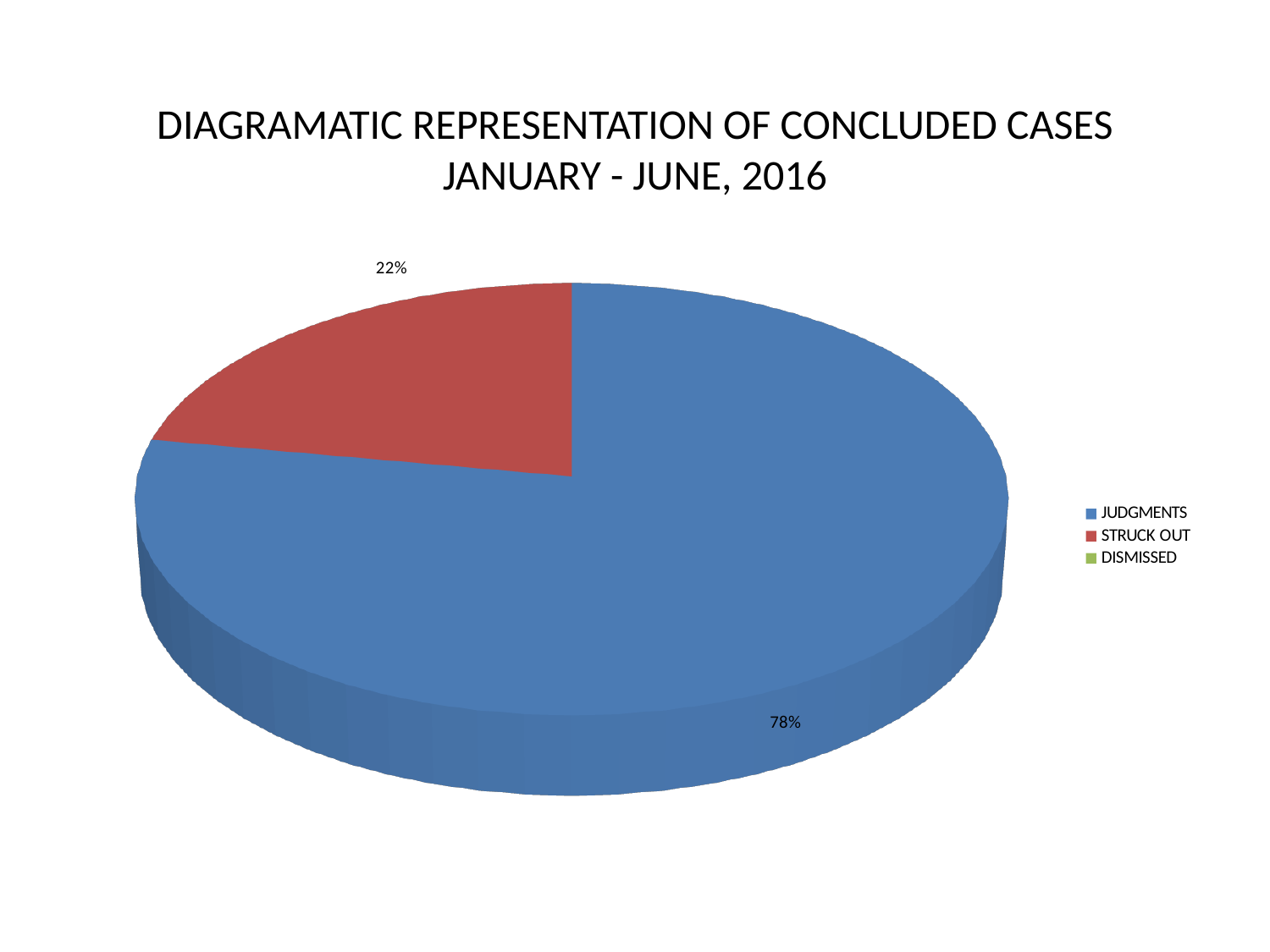
How many categories does the legend list? 3 What is the title of the chart? DIAGRAMATIC REPRESENTATION OF CONCLUDED CASES JANUARY - JUNE, 2016 Which of JUDGMENTS or STRUCK OUT has the larger share? JUDGMENTS What colour represents STRUCK OUT in the pie chart? red Is the share for STRUCK OUT greater or less than 50%? less What share of the pie does STRUCK OUT take? 22% Which category has the largest slice of the pie? JUDGMENTS What kind of chart is shown on the slide? pie chart What is the difference in percentage points between the JUDGMENTS share and the STRUCK OUT share? 56 What share of the pie does JUDGMENTS take? 78%